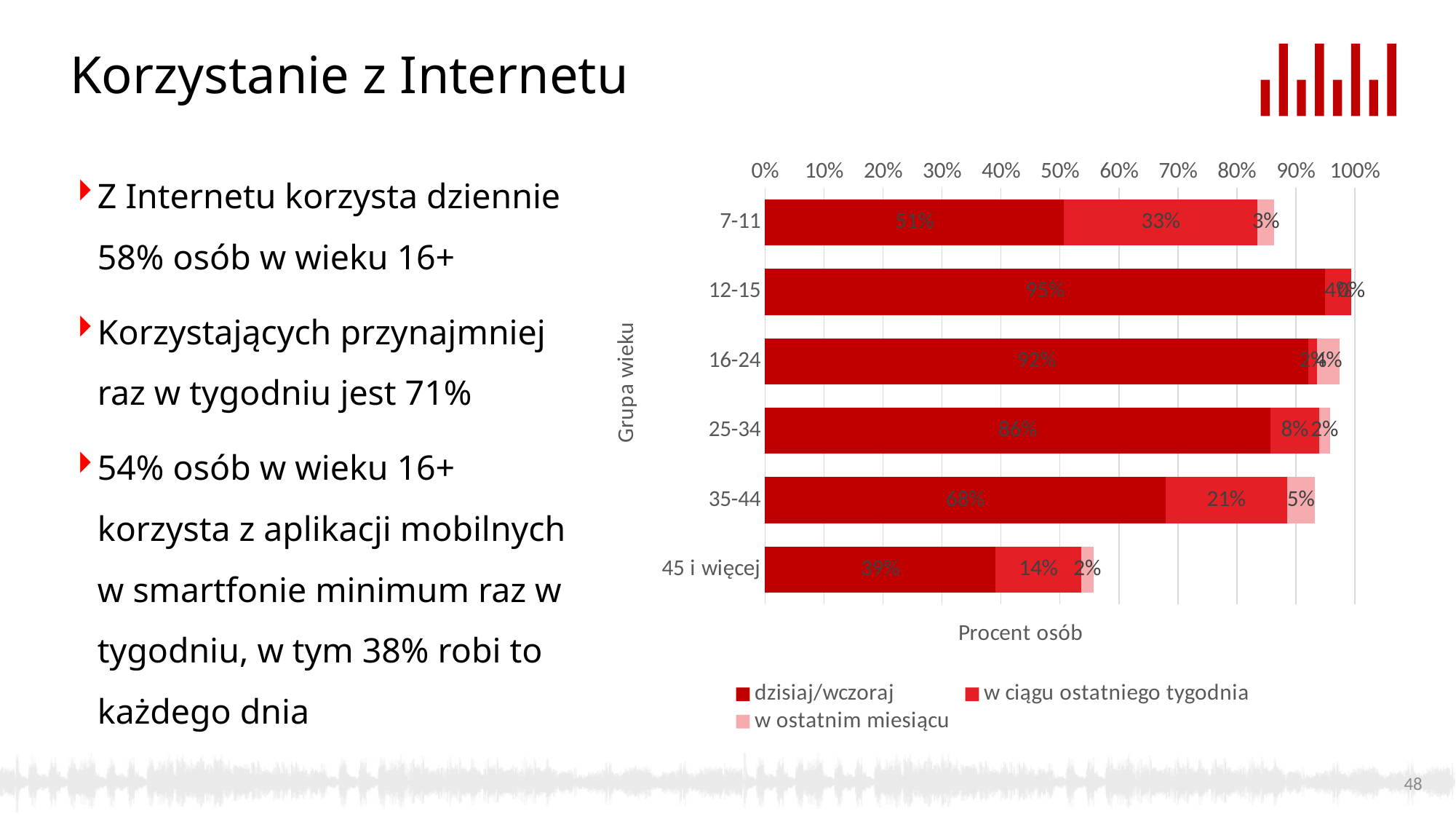
What is the total of the stacked bar for the 45 i więcej age group? 55% What kind of chart is shown on the slide? stacked bar chart Which age group has the highest 'dzisiaj/wczoraj' value? 12-15 How many series does the chart legend list? 3 Which age group has the lowest 'dzisiaj/wczoraj' value? 45 i więcej What is the 'w ciągu ostatniego tygodnia' value for the 35-44 age group? 21% What is the 'dzisiaj/wczoraj' value for the 7-11 age group? 51% How many age groups are shown on the chart? 6 What is the 'w ostatnim miesiącu' value for the 25-34 age group? 2% What is the 'dzisiaj/wczoraj' value for the 45 i więcej age group? 39% Which is larger: the 'w ciągu ostatniego tygodnia' value for 7-11 or for 45 i więcej? 7-11 What is the difference between the 'dzisiaj/wczoraj' values for the 25-34 and 35-44 age groups? 18%